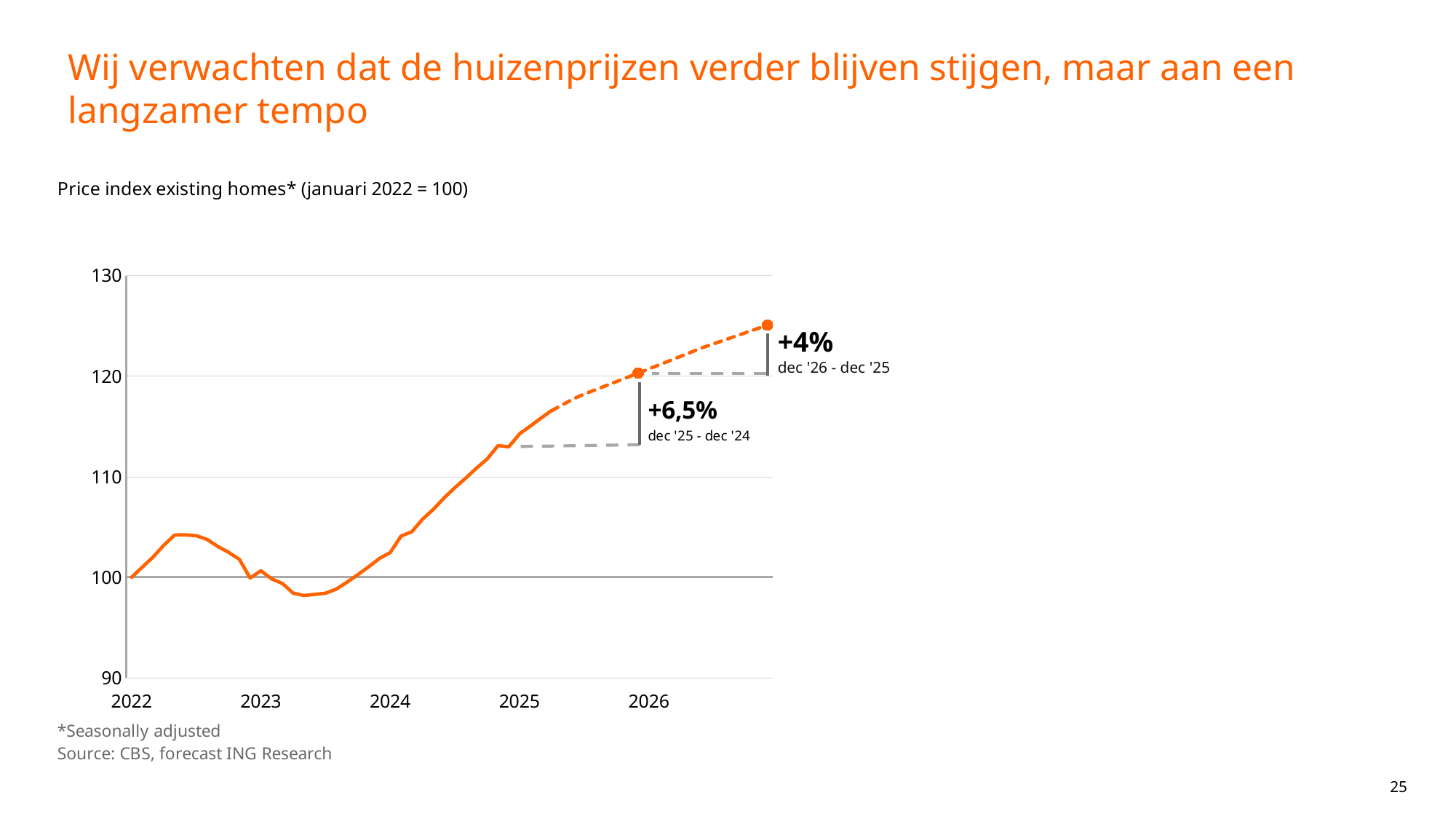
Is the value of the price index at the end of 2026 greater or less than 120? greater Is the value of the price index at the start of 2024 greater or less than 110? less What is the value of the price index in January 2022, the base period? 100 What is the title of the chart? Price index existing homes* (januari 2022 = 100) Is the value of the price index in mid-2023 greater or less than 100? less Which of the two annotated growth rates is larger, dec '25 - dec '24 or dec '26 - dec '25? dec '25 - dec '24 What kind of chart is shown on the slide? line chart What expected change in the price index is annotated for dec '25 - dec '24? +6,5% What expected change in the price index is annotated for dec '26 - dec '25? +4% Does the price index rise or fall between the start of 2024 and the end of 2026? rise What source is cited for the chart? CBS, forecast ING Research